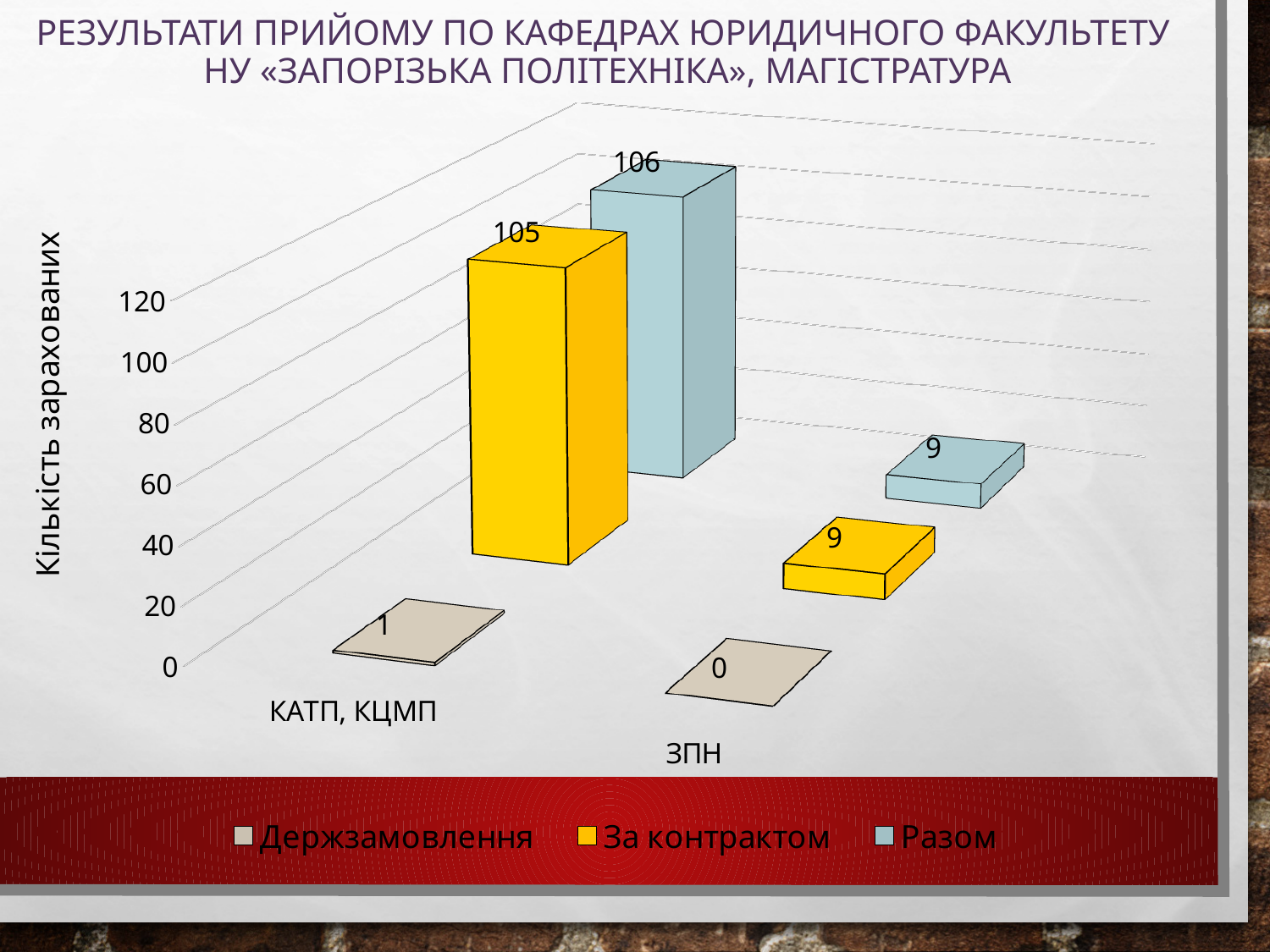
What is the difference between the За контрактом values for КАТП, КЦМП and ЗПН? 96 Which is larger: Разом for КАТП, КЦМП or Разом for ЗПН? КАТП, КЦМП How many categories are shown on the x axis? 2 What kind of chart is shown on the slide? Bar chart What is the value of Держзамовлення for ЗПН? 0 What is the value of За контрактом for ЗПН? 9 Which category has the highest Разом value? КАТП, КЦМП What is the value of За контрактом for КАТП, КЦМП? 105 What is the value of Держзамовлення for КАТП, КЦМП? 1 How many series does the legend list? 3 Which category has the lowest За контрактом value? ЗПН What is the value of Разом for КАТП, КЦМП? 106